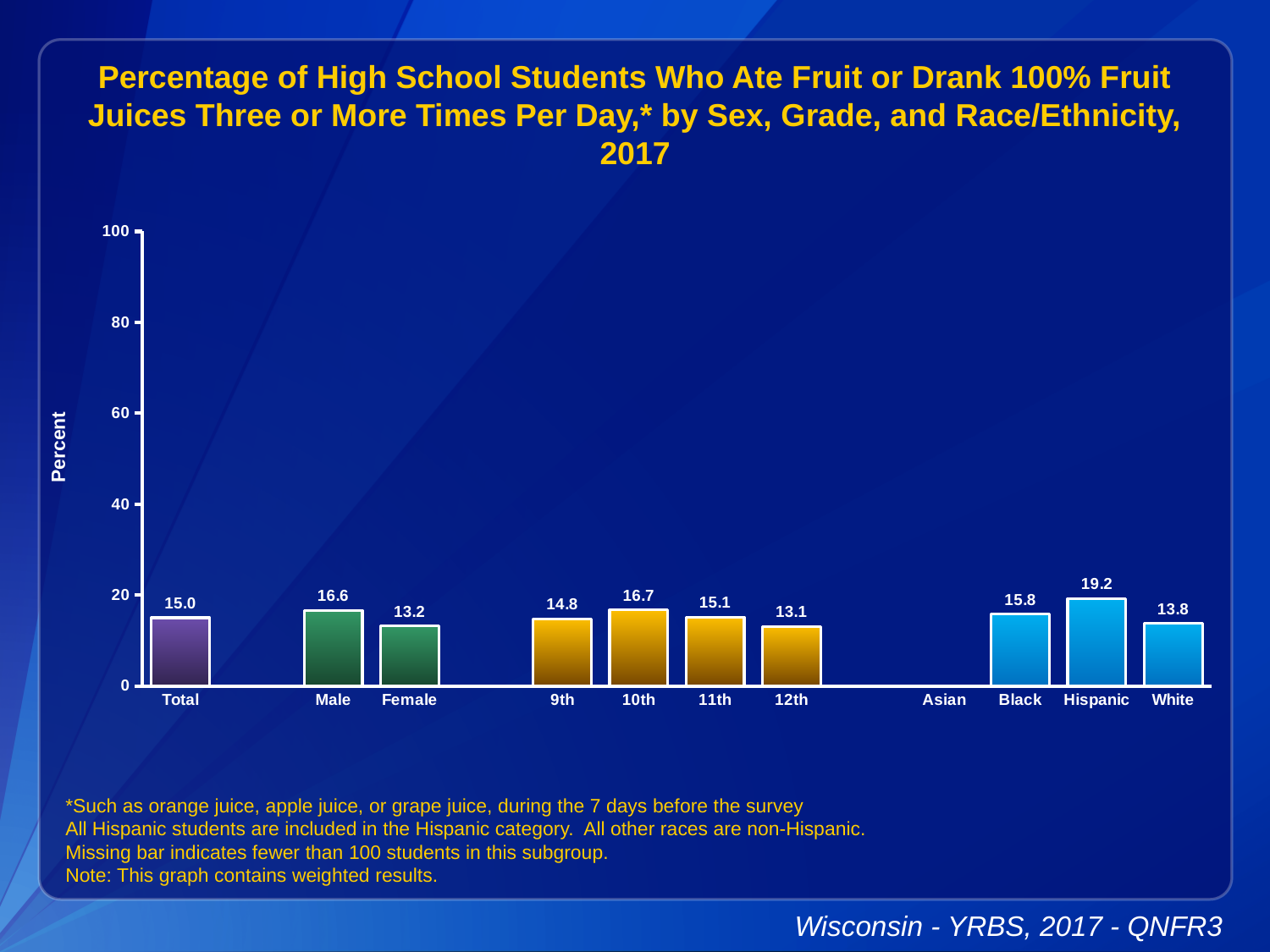
What kind of chart is this? bar chart What is the difference between the Male and Female values? 3.4 What is the value for Total? 15.0 Which is larger, the value for Black or the value for White? Black Is the value for Hispanic greater or less than 20? less What is the label on the y axis? Percent Which category label has no bar plotted? Asian What is the value for Hispanic students? 19.2 How many bars are plotted on the chart? 11 What is the value for 10th grade? 16.7 Which category has the highest value? Hispanic Which category has the lowest value? 12th